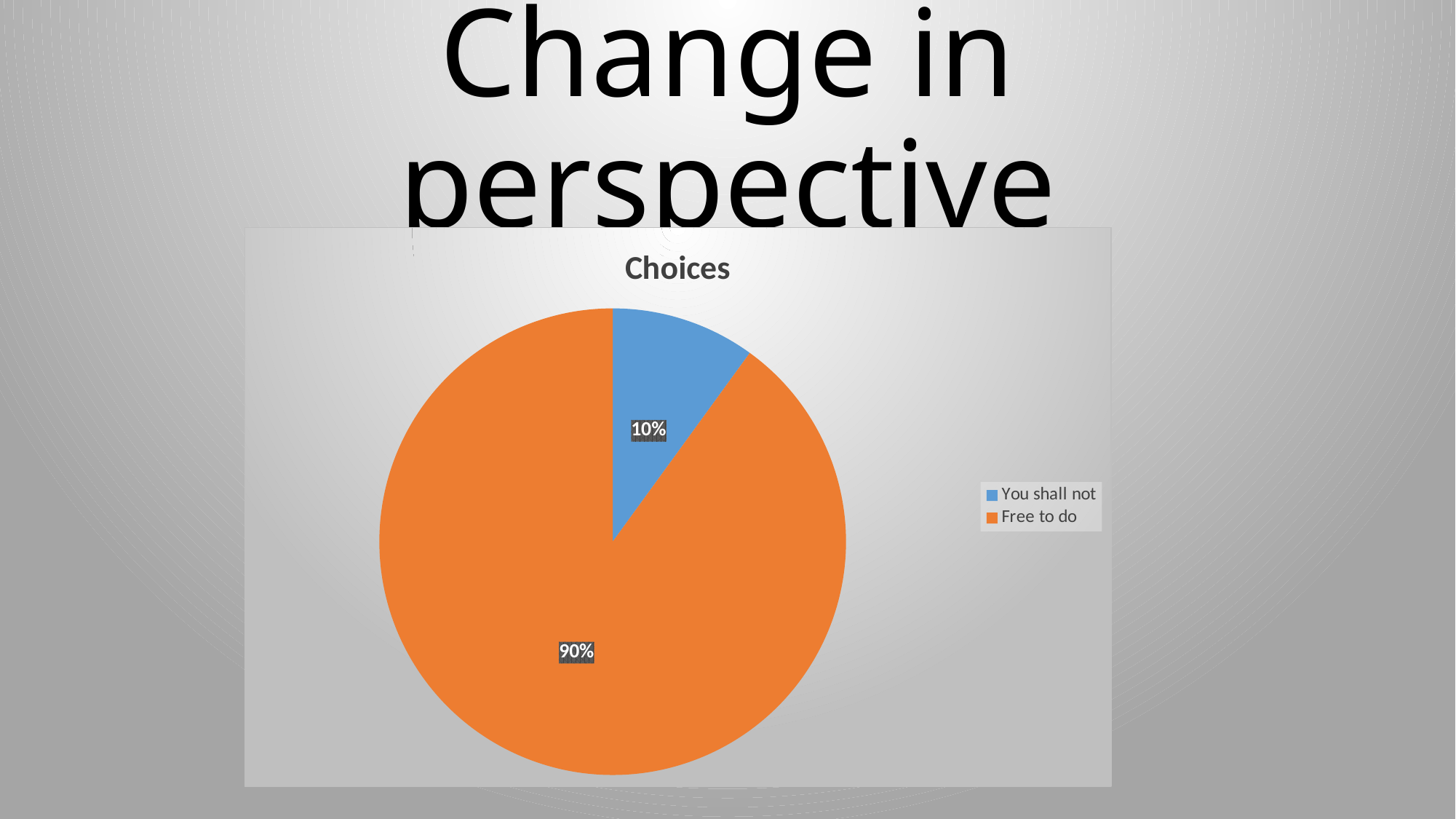
Which category has the smallest slice of the pie? You shall not What is the title of the chart? Choices Which category has the largest slice of the pie? Free to do Which slice is larger, "You shall not" or "Free to do"? Free to do What share of the pie does "Free to do" take? 90% How many entries does the legend list? 2 How many categories does the pie chart show? 2 What colour is the "You shall not" slice? blue What kind of chart is shown on the slide? pie chart What share of the pie does "You shall not" take? 10% What is the difference in percentage points between the "Free to do" and "You shall not" slices? 80